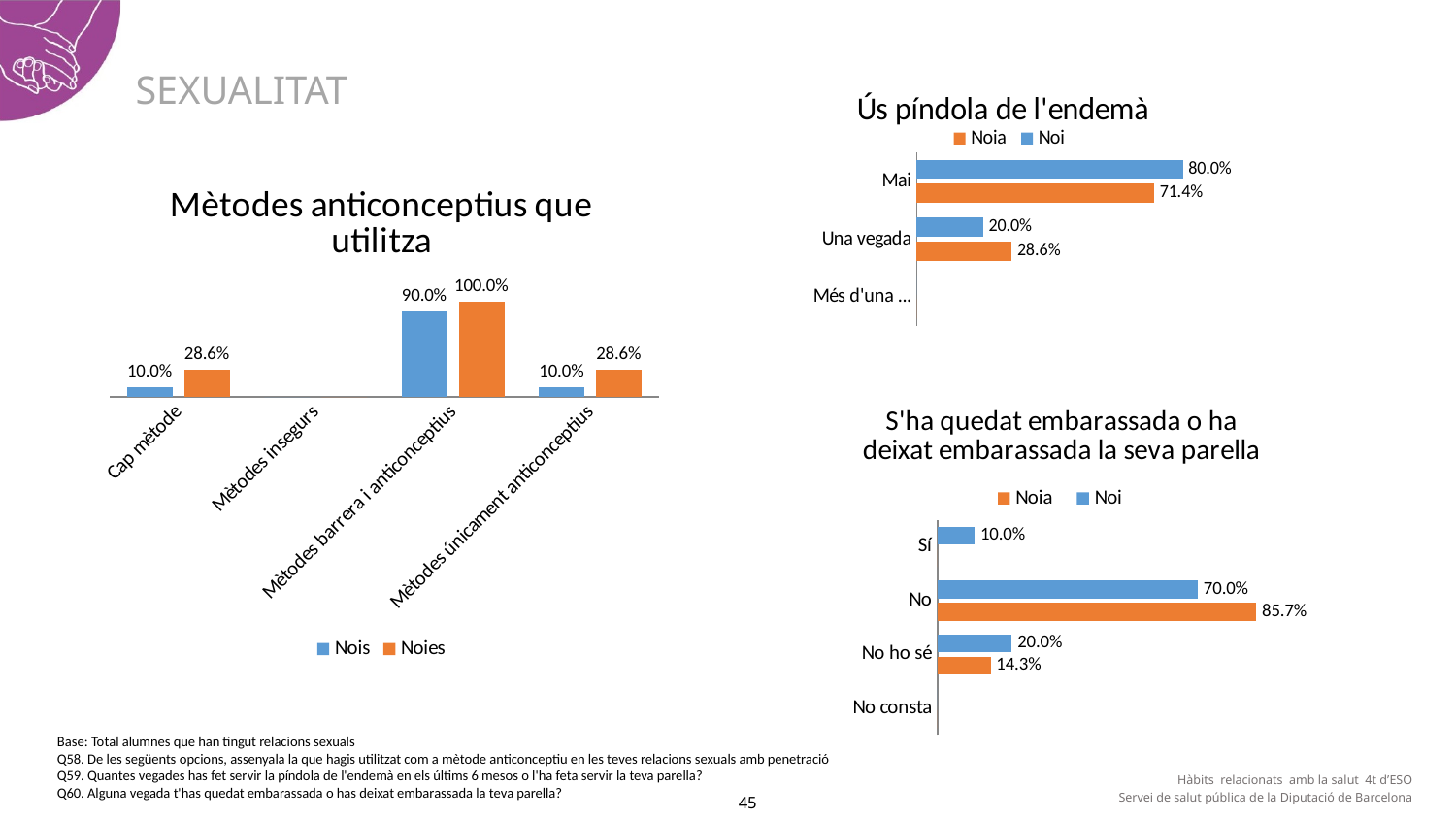
In the chart 'Mètodes anticonceptius que utilitza', how many series does the legend list? 2 In the chart 'Mètodes anticonceptius que utilitza', what is the value for Nois in the category 'Cap mètode'? 10.0% In the chart 'S'ha quedat embarassada o ha deixat embarassada la seva parella', what is the difference between the Noi and Noia values for 'No ho sé'? 5.7% In the chart 'Ús píndola de l'endemà', which is larger for 'Mai': the Noi value or the Noia value? Noi In the chart 'Mètodes anticonceptius que utilitza', which category has the highest value for Nois? Mètodes barrera i anticonceptius In the chart 'Mètodes anticonceptius que utilitza', what is the difference between the Noies and Nois values for 'Cap mètode'? 18.6% In the chart 'S'ha quedat embarassada o ha deixat embarassada la seva parella', what is the value for Noia in the category 'No'? 85.7% In the chart 'S'ha quedat embarassada o ha deixat embarassada la seva parella', how many categories are shown on the vertical axis? 4 What kind of chart is 'Ús píndola de l'endemà'? Bar chart In the chart 'Mètodes anticonceptius que utilitza', what is the value for Noies in the category 'Mètodes barrera i anticonceptius'? 100.0% In the chart 'Ús píndola de l'endemà', what is the value for Noia in the category 'Una vegada'? 28.6% In the chart 'Ús píndola de l'endemà', what is the value for Noi in the category 'Mai'? 80.0%